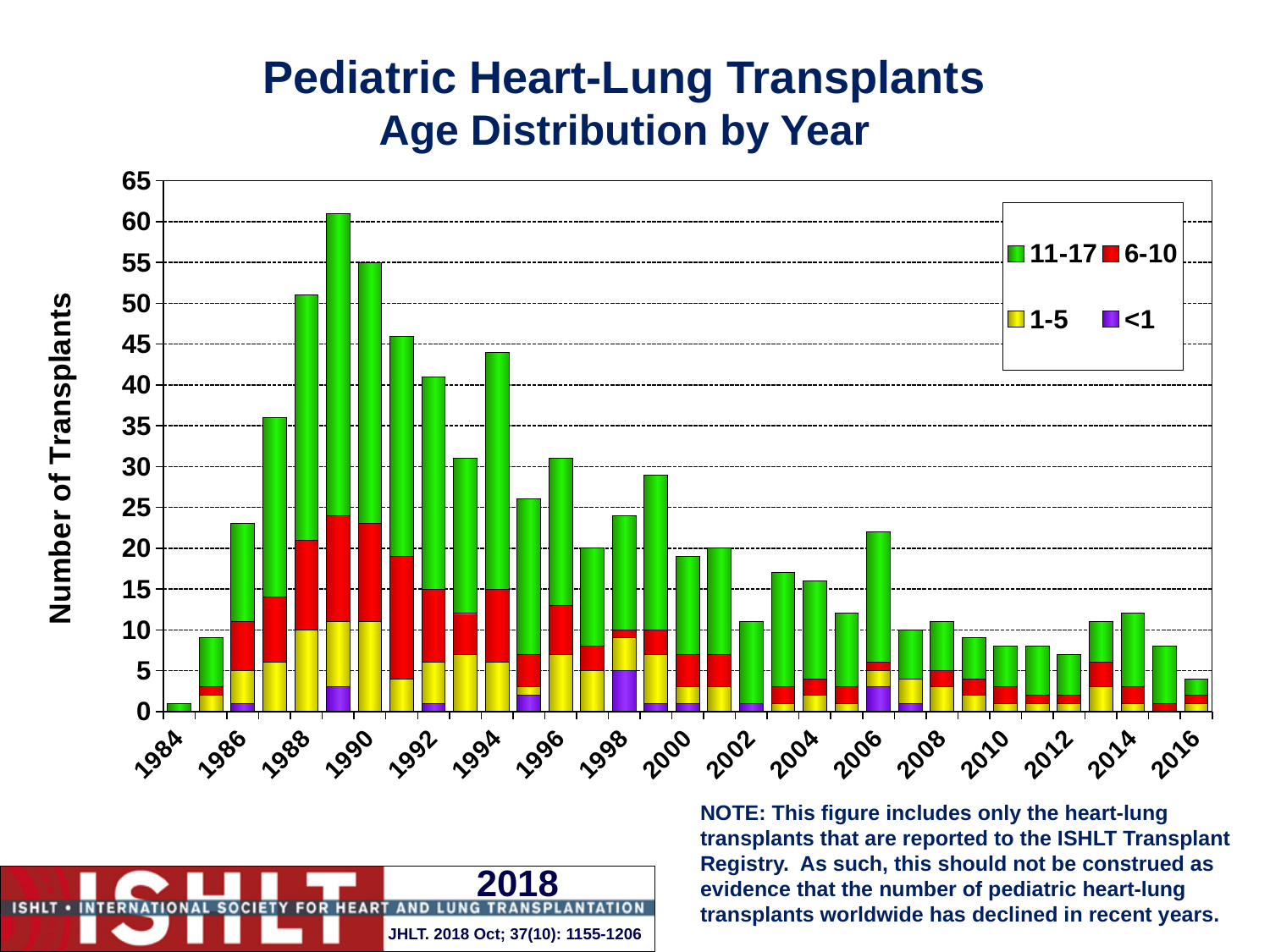
Which year has the lowest total number of transplants? 1984 Is the total number of transplants in 1989 greater or less than 55? greater What kind of chart is shown on the slide? Stacked bar chart Which age groups are listed in the legend? 11-17, 6-10, 1-5, <1 How many series does the legend list? 4 Do the total transplants generally rise or fall from 1989 to 2016? fall How many years (bars) are plotted on the chart? 33 Is the total number of transplants in 1990 greater or less than 50? greater Which year has a higher total number of transplants, 1986 or 1987? 1987 Is the total number of transplants in 2016 greater or less than 10? less Which year has the highest total number of transplants? 1989 What is the label of the vertical axis? Number of Transplants